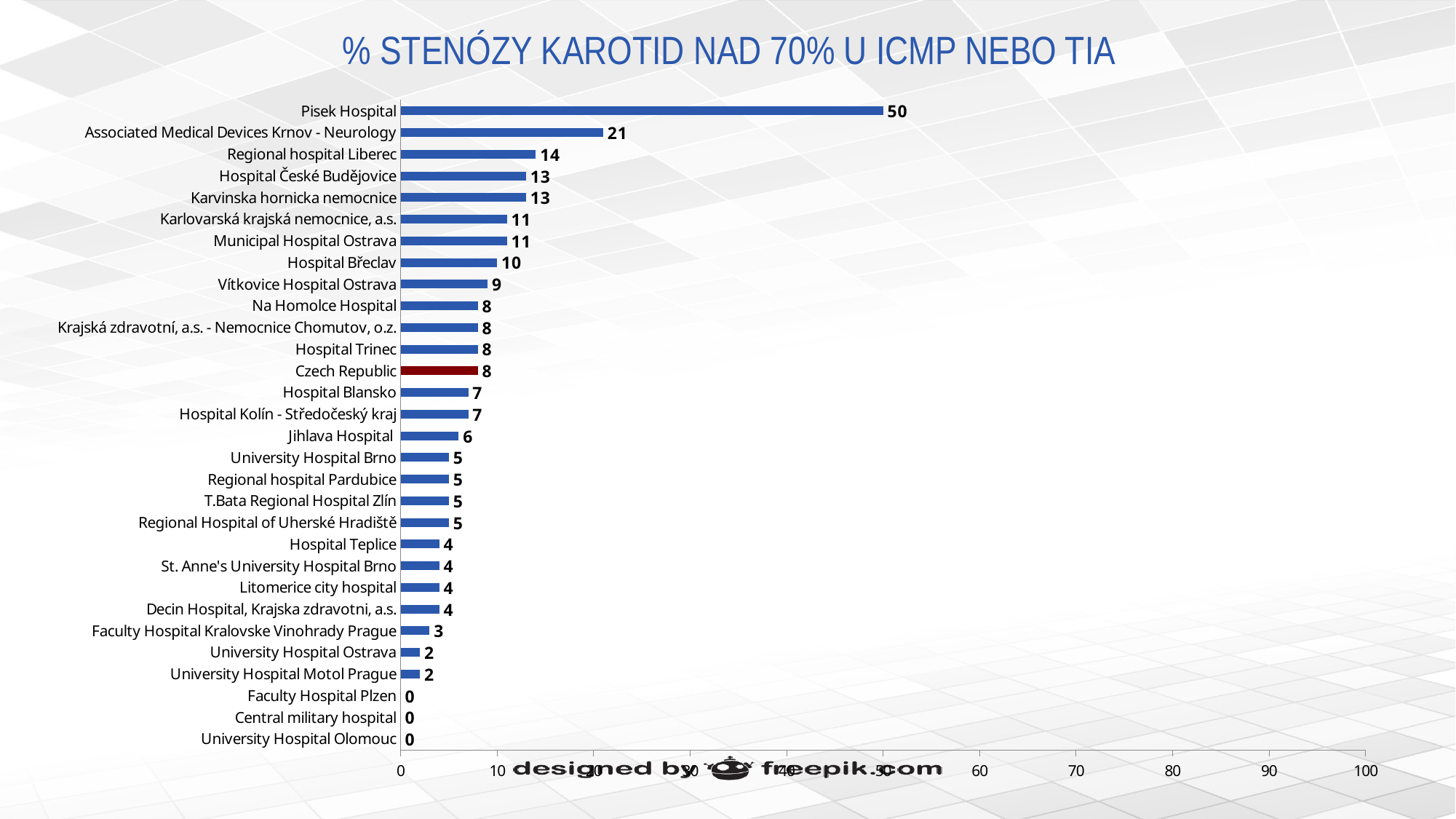
What is the difference between the values for Pisek Hospital and Associated Medical Devices Krnov - Neurology? 29 What is the value for University Hospital Motol Prague? 2 What is the value for Czech Republic? 8 What is the difference between the values for Hospital Břeclav and Jihlava Hospital? 4 Which is larger, the value for Vítkovice Hospital Ostrava or the value for Hospital Blansko? Vítkovice Hospital Ostrava What is the value for Pisek Hospital? 50 Which category's bar is coloured dark red instead of blue? Czech Republic What kind of chart is shown on the slide? bar chart Is the value for Associated Medical Devices Krnov - Neurology greater or less than 30? less Which category has the highest value? Pisek Hospital What is the value for Regional hospital Liberec? 14 How many categories are shown on the chart? 30